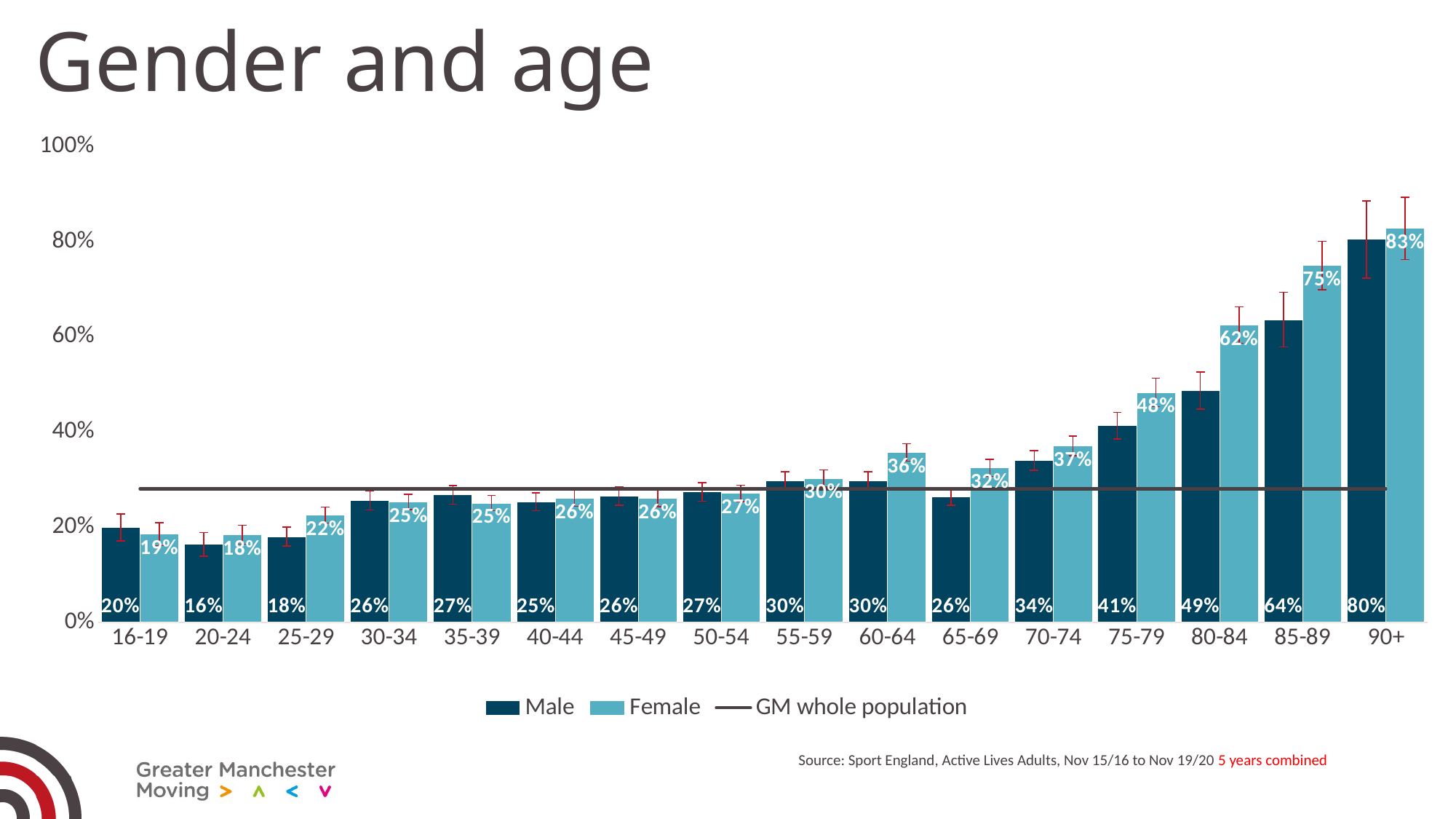
How many entries does the legend list? 3 What is the difference between the Female and Male values for the 90+ age group? 3 percentage points Is the GM whole population line greater or less than 40%? less What is the Female value for the 60-64 age group? 36% Which age group has the lowest Male value? 20-24 Do the Male values rise or fall from the 70-74 age group to the 90+ age group? Rise For the 85-89 age group, which is larger, the Male or the Female value? Female What is the Male value for the 75-79 age group? 41% Which age group has the highest Male value? 90+ What kind of chart is shown on the slide? Combination bar and line chart How many age groups are shown on the x axis? 16 Which age group has the lowest Female value? 20-24